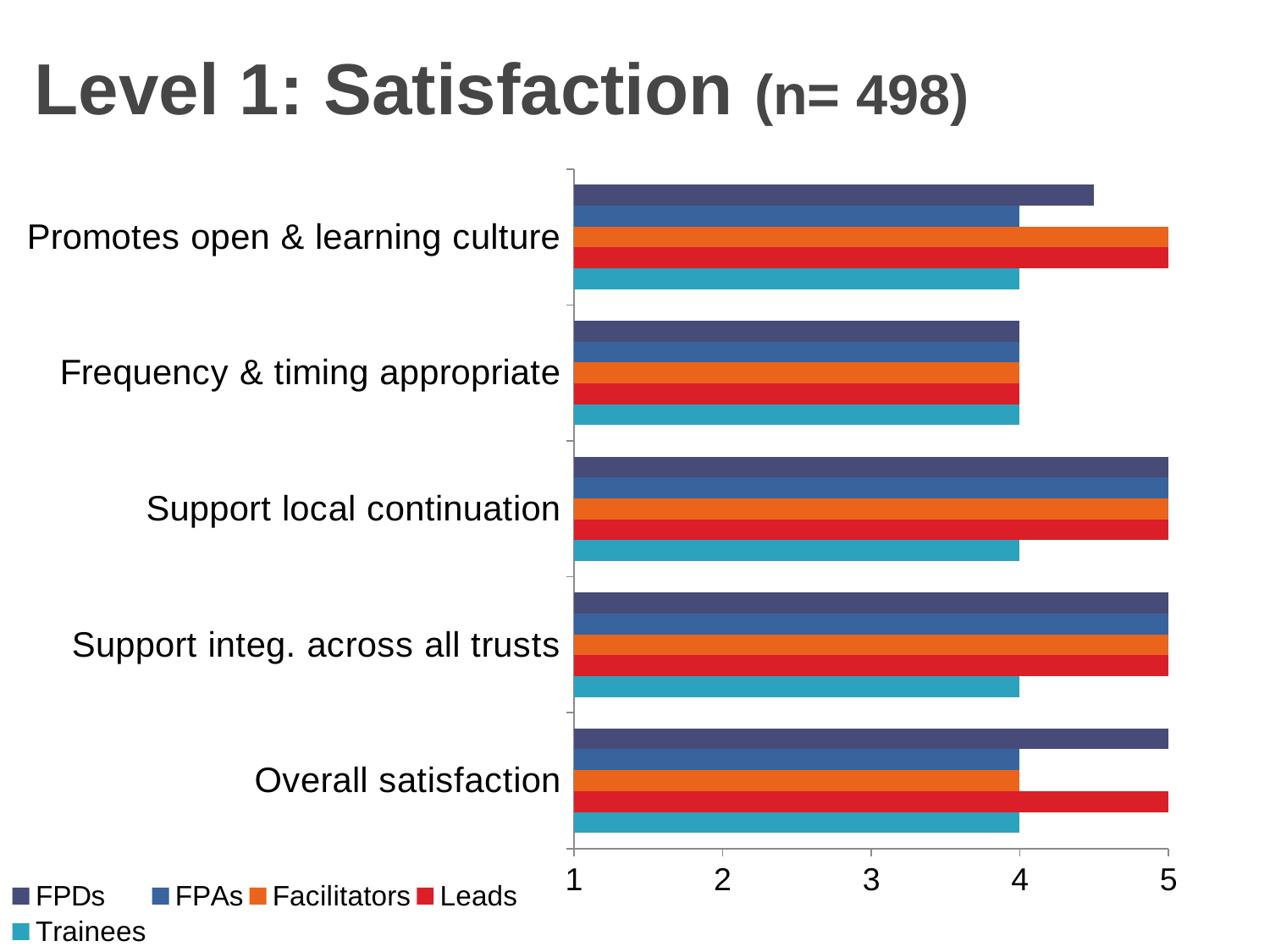
What is the value for Facilitators on Promotes open & learning culture? 5 What is the value for FPAs on Frequency & timing appropriate? 4 Which is larger on Overall satisfaction: the value for FPDs or the value for FPAs? FPDs Which series is shown in red in the legend? Leads What is the value for Leads on Overall satisfaction? 5 Which series has the lowest value on Support local continuation? Trainees Is the value for FPDs on Promotes open & learning culture greater or less than 4? greater What is the value for Trainees on Overall satisfaction? 4 What is the difference between the Leads value and the Trainees value on Support integ. across all trusts? 1 How many series does the legend list? 5 What kind of chart is shown on the slide? bar chart How many categories are shown on the chart? 5